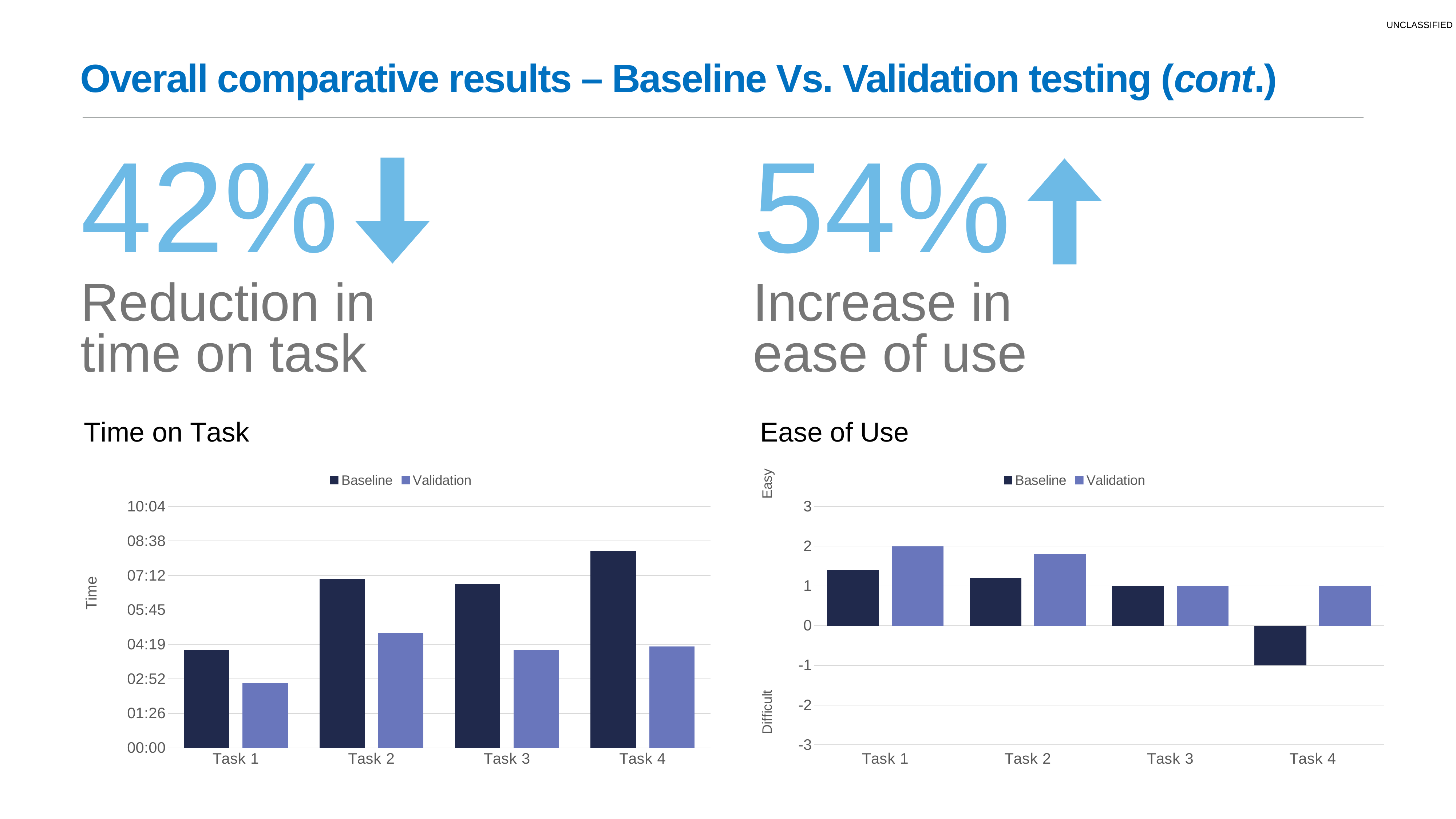
In the Time on Task chart, is the Baseline value for Task 4 greater or less than 07:12? greater What are the two series named in the legend of the Ease of Use chart? Baseline and Validation In the Ease of Use chart, what is the Baseline value for Task 4? -1 What kind of chart is the Time on Task chart? bar chart How many tasks are shown on the x axis of the Ease of Use chart? 4 In the Time on Task chart, which task has the lowest Validation value? Task 1 In the Time on Task chart, which task has the highest Baseline value? Task 4 How many series does the legend of the Time on Task chart list? 2 In the Ease of Use chart, what is the Validation value for Task 1? 2 In the Ease of Use chart, which task has the lowest Baseline value? Task 4 In the Ease of Use chart, for Task 2, which is larger: Baseline or Validation? Validation In the Time on Task chart, for Task 2, which is larger: Baseline or Validation? Baseline